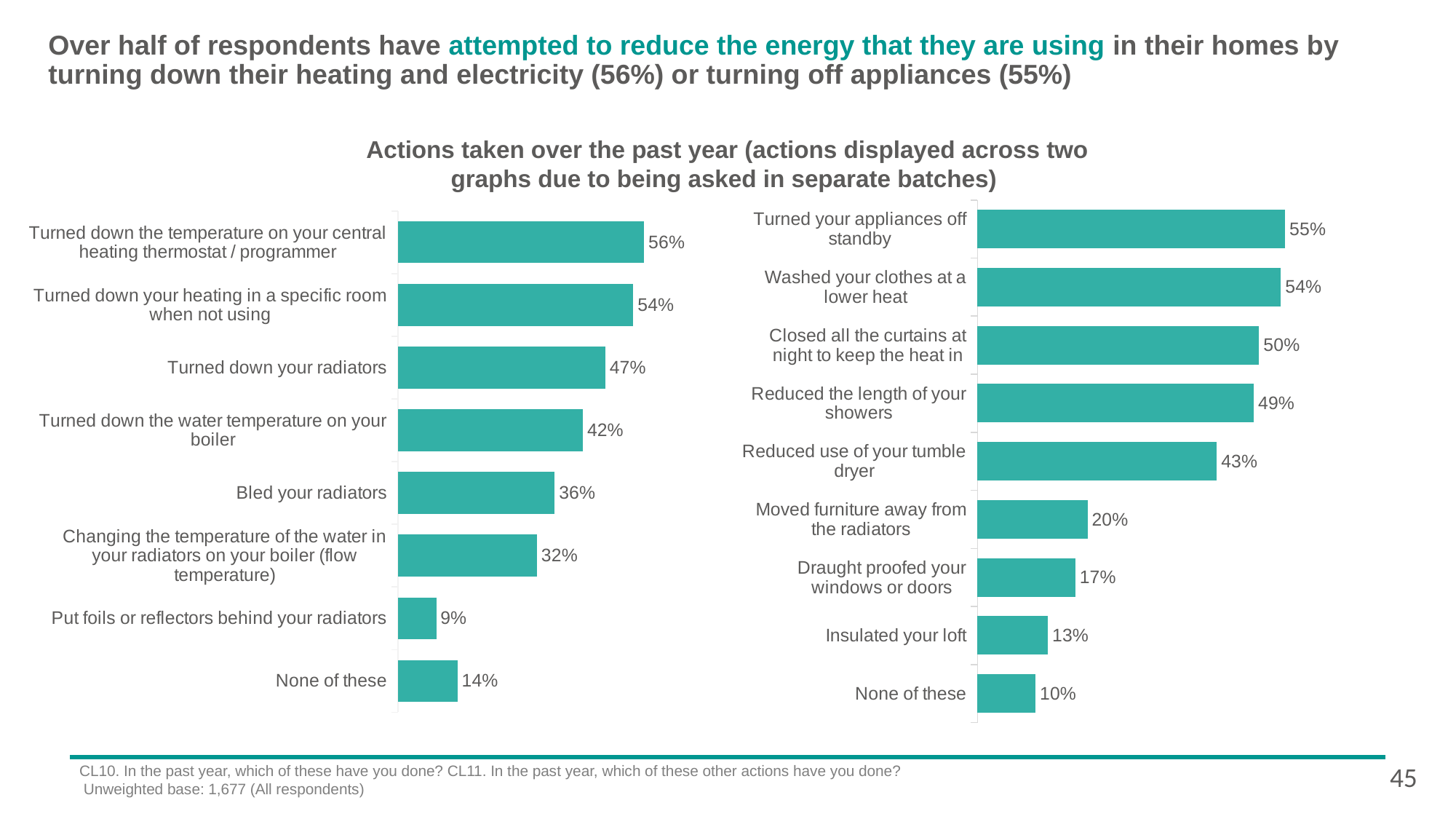
In the left chart, which is larger: 'Changing the temperature of the water in your radiators on your boiler (flow temperature)' or 'None of these'? Changing the temperature of the water in your radiators on your boiler (flow temperature) In the left chart, what percentage of respondents turned down the temperature on their central heating thermostat / programmer? 56% What type of chart is used on this slide? Bar chart How many categories are shown in the left chart? 8 In the right chart, what is the value for 'Insulated your loft'? 13% In the right chart, which action has the highest percentage? Turned your appliances off standby How many categories are shown in the right chart? 9 In the right chart, what percentage of respondents washed their clothes at a lower heat? 54% In the left chart, what is the value for 'Bled your radiators'? 36% In the right chart, what is the difference between 'Reduced use of your tumble dryer' and 'Moved furniture away from the radiators'? 23% In the left chart, what is the difference between 'Turned down your radiators' and 'Turned down the water temperature on your boiler'? 5% In the left chart, which action has the lowest percentage? Put foils or reflectors behind your radiators